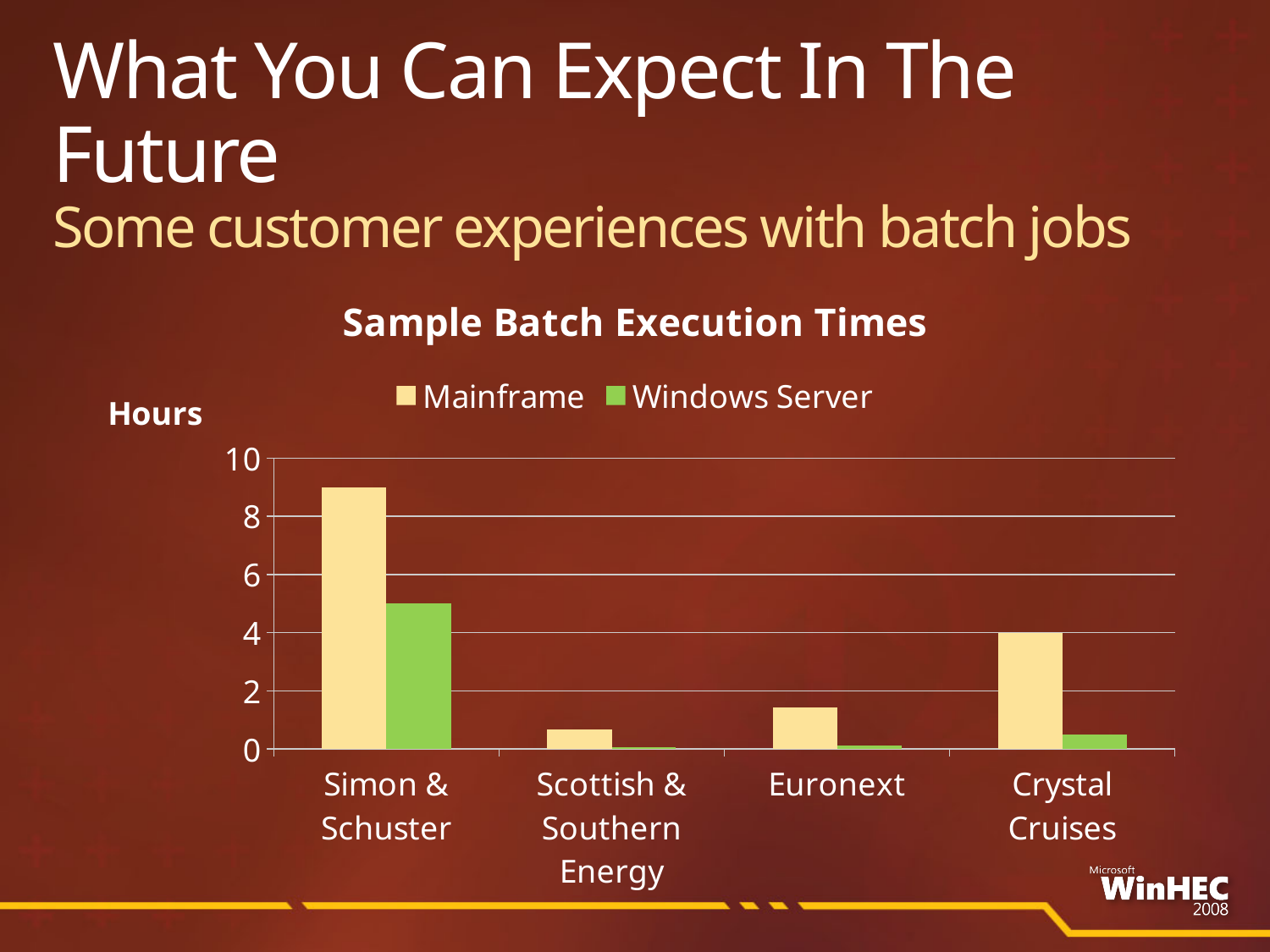
How many series does the legend list? 2 What is the title of the chart? Sample Batch Execution Times Which customer has the highest Mainframe batch execution time? Simon & Schuster Is the Windows Server value for Simon & Schuster greater or less than 6? less Is the Mainframe value for Simon & Schuster greater or less than 8? greater What unit is shown on the vertical axis label? Hours How many customer categories are shown on the x axis? 4 Which customer has the highest Windows Server batch execution time? Simon & Schuster Is the Mainframe value for Euronext greater or less than 2? less What kind of chart is shown on the slide? bar chart Which customer has the lowest Mainframe batch execution time? Scottish & Southern Energy For Crystal Cruises, which is larger: the Mainframe value or the Windows Server value? Mainframe